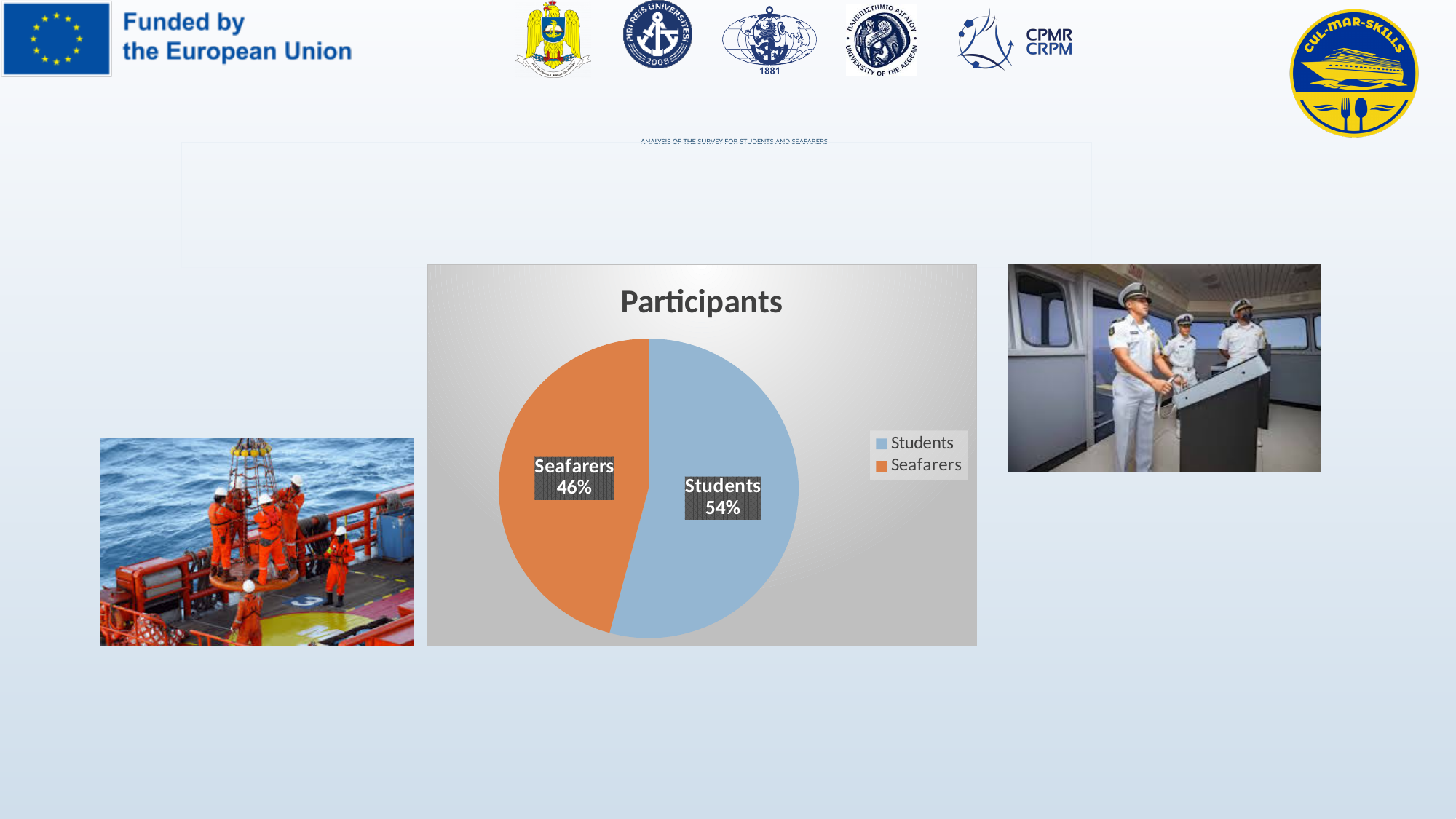
What share of participants are Seafarers? 46% Is the Students share greater or less than 50%? greater How many categories does the pie chart show? 2 What share of participants are Students? 54% Which is larger, the Students share or the Seafarers share? Students Which category has the smallest share of participants? Seafarers What is the title of the chart? Participants What kind of chart is shown on the slide? pie chart Which category has the largest share of participants? Students What colour is the Seafarers slice? orange How many entries does the legend list? 2 What is the difference in percentage points between the Students and Seafarers shares? 8 percentage points